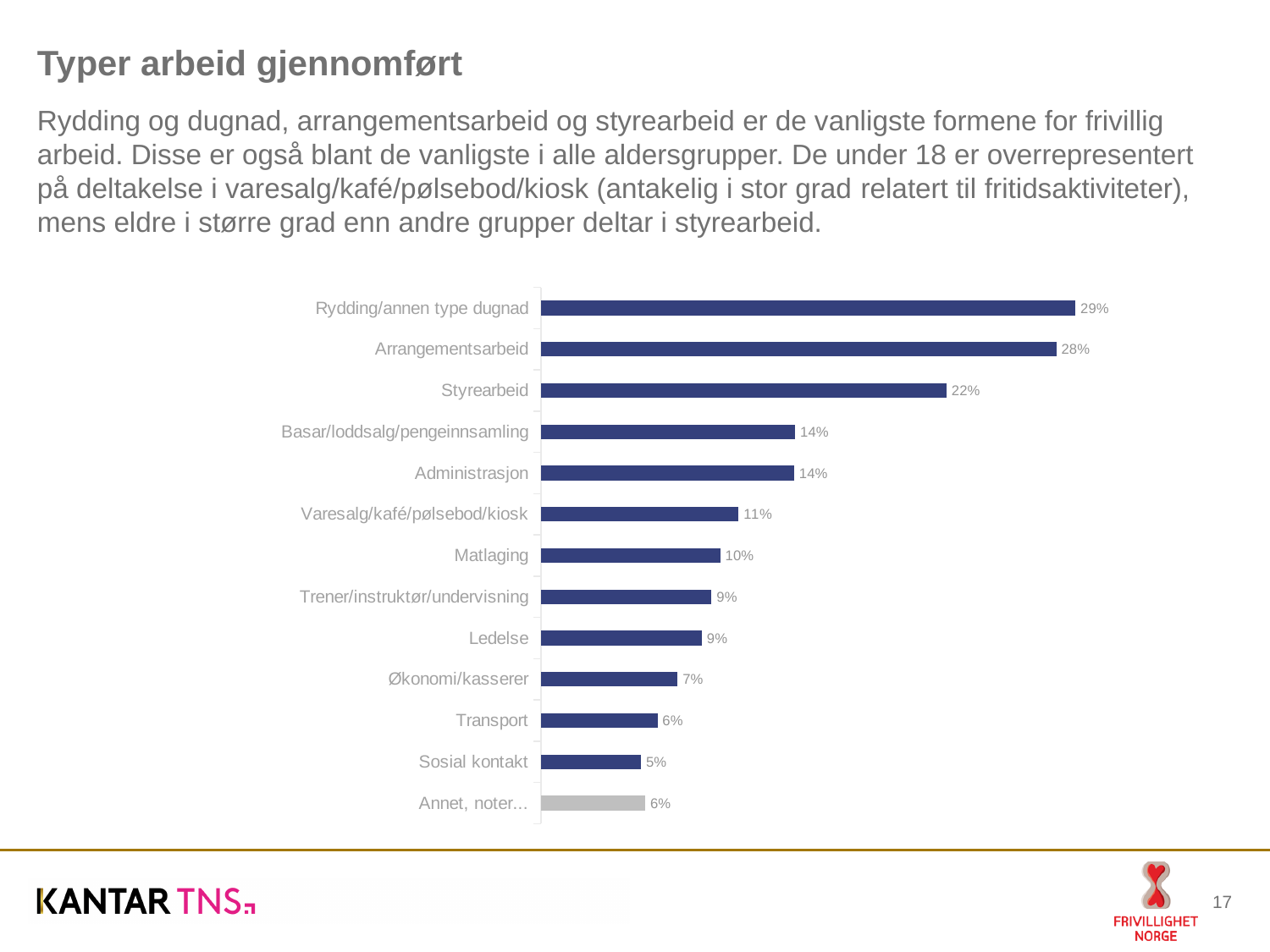
What is the value for Varesalg/kafé/pølsebod/kiosk? 11% What is the value for Styrearbeid? 22% Which category has the lowest value? Sosial kontakt What is the value for Transport? 6% What is the value for Matlaging? 10% Which category has the highest value? Rydding/annen type dugnad What is the difference between the values for Arrangementsarbeid and Administrasjon? 14% Which category's bar is coloured grey instead of dark blue? Annet, noter... What kind of chart is shown on the slide? Bar chart What is the difference between the values for Rydding/annen type dugnad and Styrearbeid? 7% How many categories are shown in the chart? 13 Which is larger, the value for Økonomi/kasserer or the value for Ledelse? Ledelse